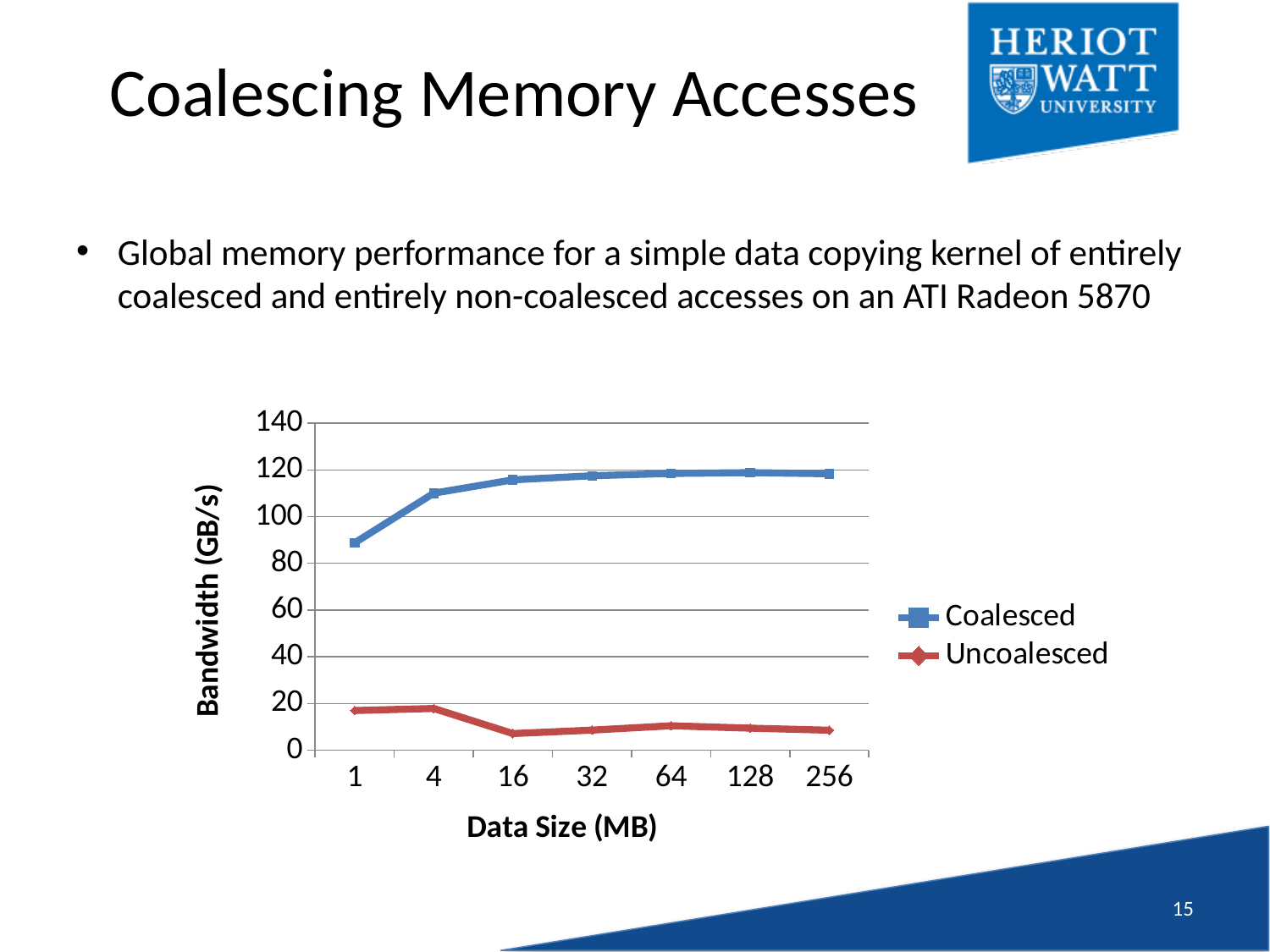
Is the Uncoalesced bandwidth at 256 MB greater or less than 40? less Is the Coalesced bandwidth at 64 MB greater or less than 100? greater What kind of chart is shown on the slide? line chart At 32 MB, which series has the higher bandwidth, Coalesced or Uncoalesced? Coalesced How many data size categories are shown on the x axis? 7 Is the Uncoalesced bandwidth at 16 MB greater or less than 20? less How many series does the chart legend list? 2 At which data size is the Coalesced bandwidth lowest? 1 What is the label of the y axis? Bandwidth (GB/s) Does the Coalesced bandwidth rise or fall from 1 MB to 4 MB? rise